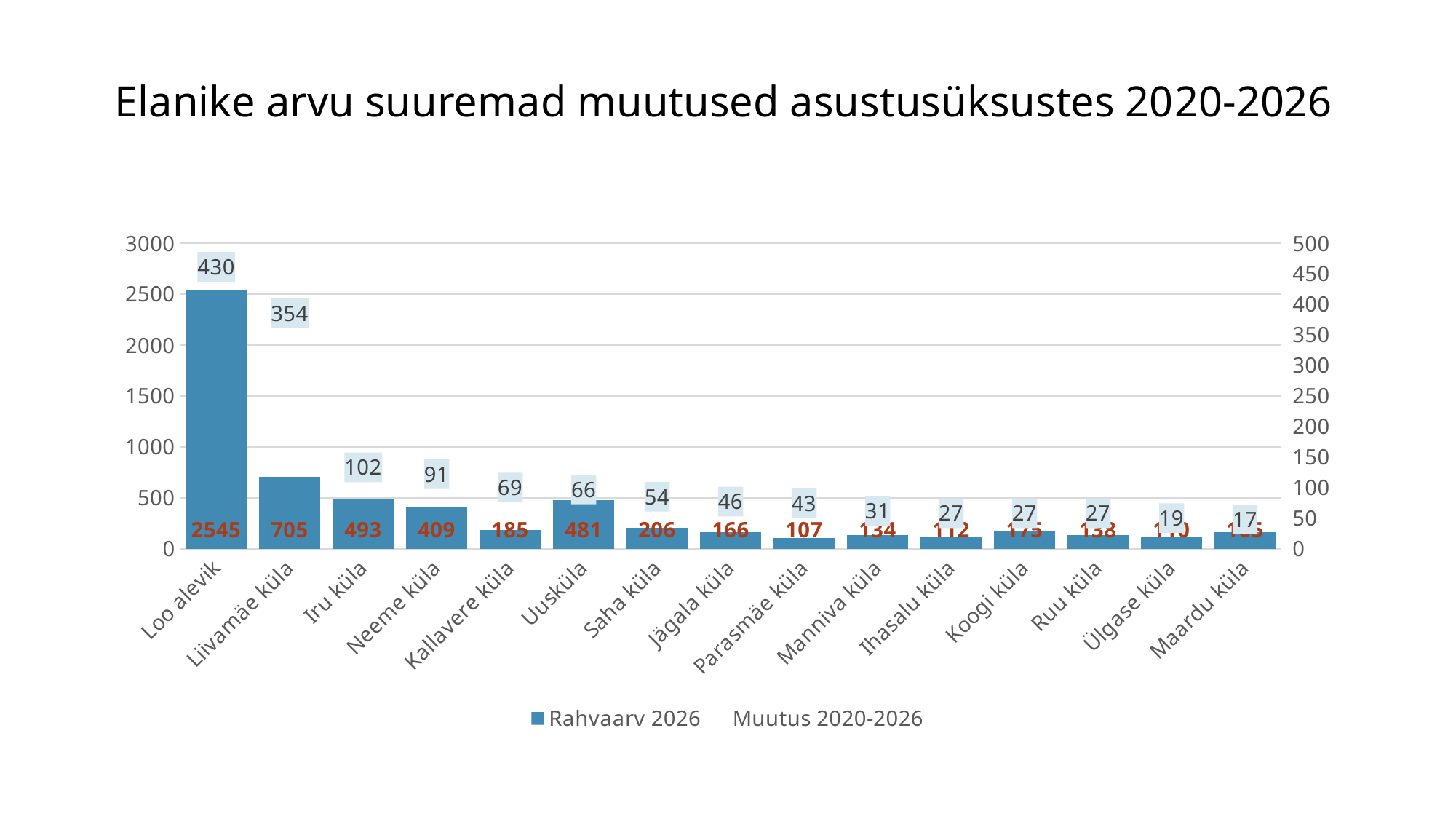
Is the Rahvaarv 2026 value for Liivamäe küla greater or less than 500? greater How many categories are shown on the x axis? 15 Which category has the lowest Muutus 2020-2026 value? Maardu küla What is the Rahvaarv 2026 value for Neeme küla? 409 What is the Rahvaarv 2026 value for Loo alevik? 2545 How many series does the legend list? 2 What is the Muutus 2020-2026 value for Liivamäe küla? 354 What is the title of the chart? Elanike arvu suuremad muutused asustusüksustes 2020-2026 What is the difference between the Rahvaarv 2026 values for Loo alevik and Liivamäe küla? 1840 What is the Muutus 2020-2026 value for Saha küla? 54 Which category has the highest Rahvaarv 2026 value? Loo alevik Which has a larger Rahvaarv 2026 value, Iru küla or Uusküla? Iru küla